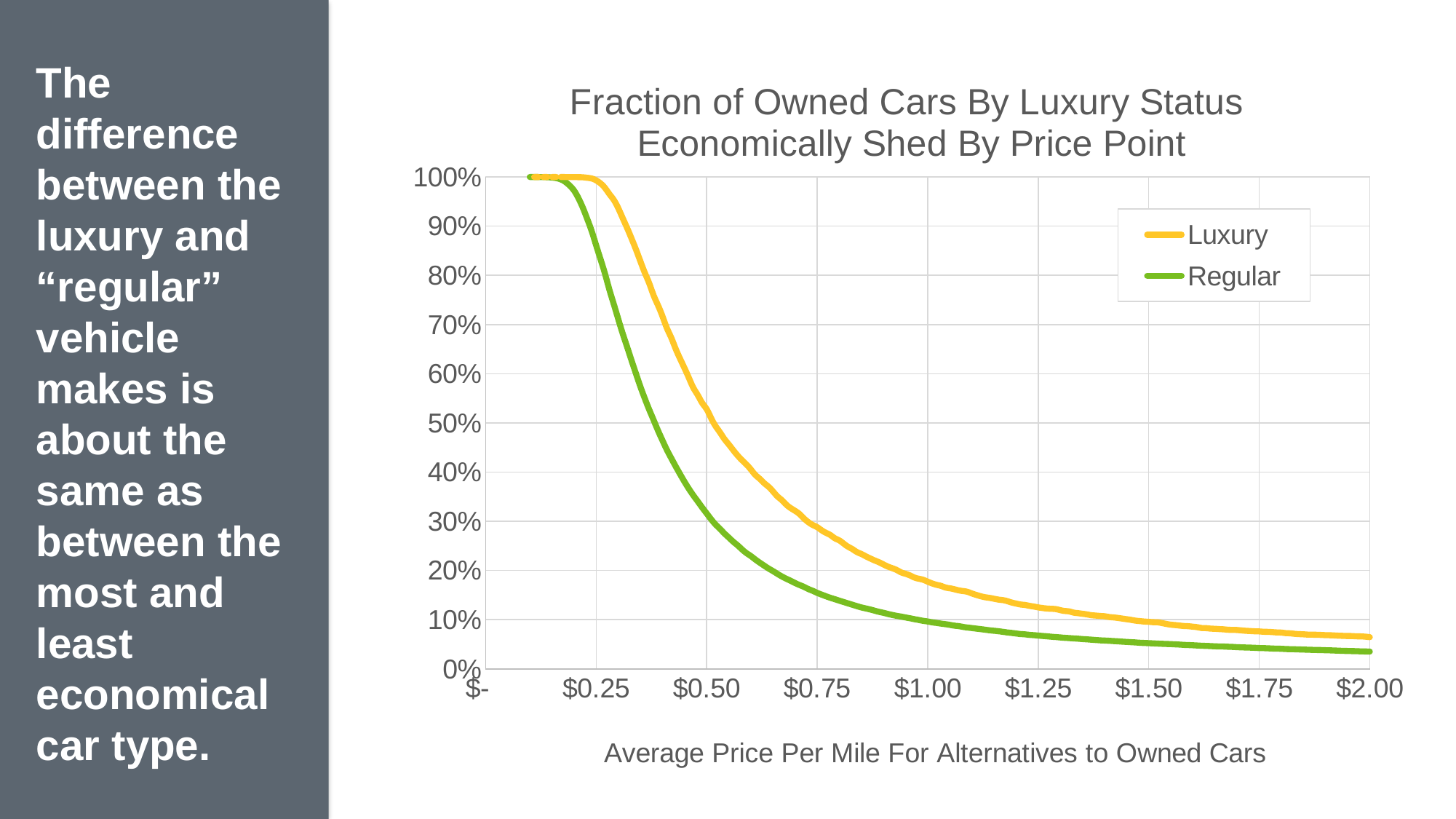
What is the x-axis label of the chart? Average Price Per Mile For Alternatives to Owned Cars At $0.50 per mile, which series has the larger value, Luxury or Regular? Luxury Is the value for the Luxury series at $1.00 per mile greater or less than 10%? greater At $1.00 per mile, which series has the smaller value, Luxury or Regular? Regular Is the value for the Regular series at $1.50 per mile greater or less than 10%? less How many series does the legend list? 2 Is the value for the Regular series at $0.75 per mile greater or less than 20%? less Do the values for the Regular series rise or fall as the price per mile increases along the x axis? Fall Do the values for the Luxury series rise or fall as the price per mile increases along the x axis? Fall What kind of chart is shown on the slide? Line chart What are the two series named in the legend? Luxury and Regular